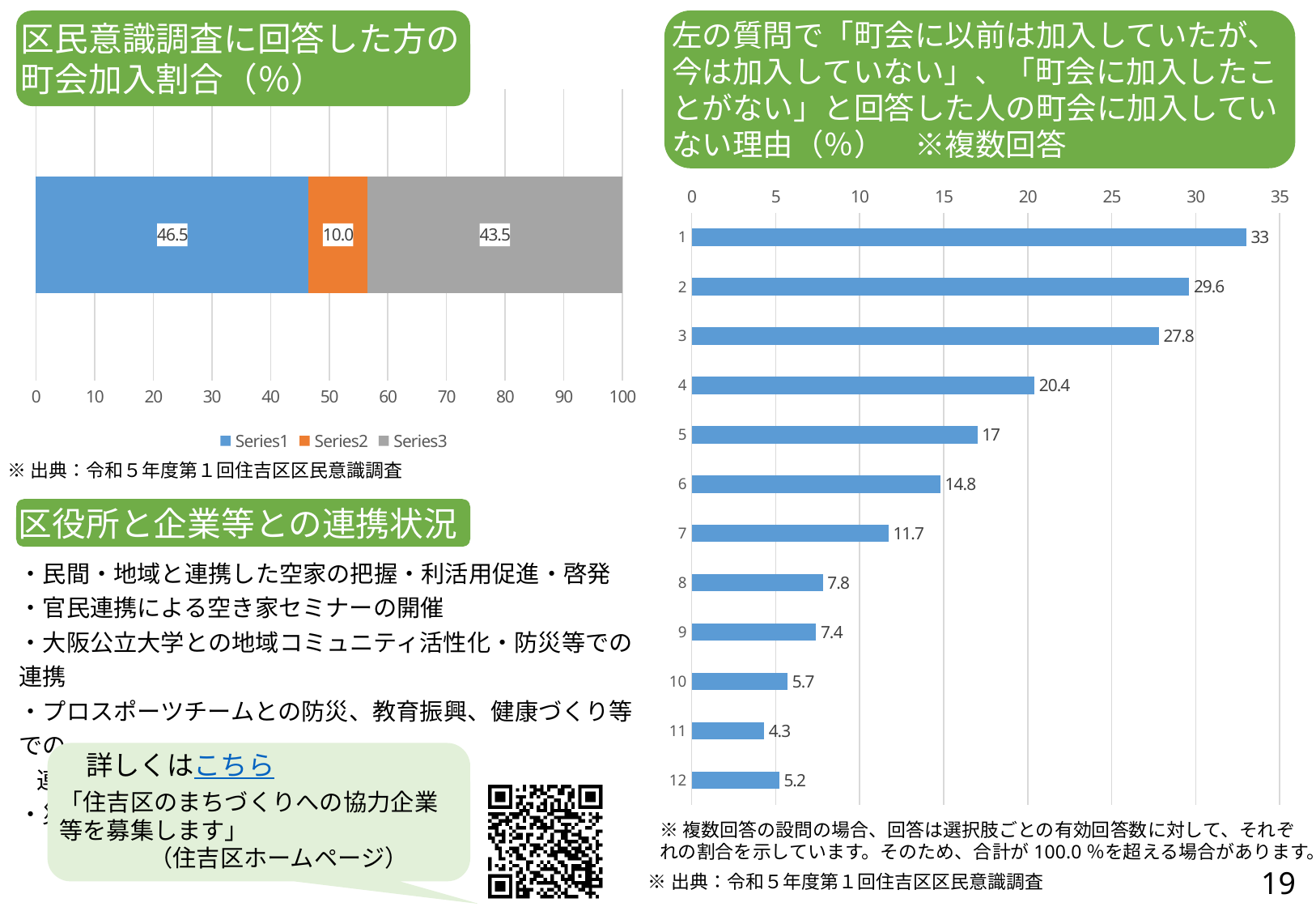
In the right chart (町会に加入していない理由), what is the value for category 1? 33 In the right chart (町会に加入していない理由), what is the value for category 7? 11.7 In the left chart (区民意識調査に回答した方の町会加入割合), which series has the smallest value? Series2 In the right chart (町会に加入していない理由), which category has the lowest value? 11 In the left chart (区民意識調査に回答した方の町会加入割合), what is the value for Series1? 46.5 In the left chart (区民意識調査に回答した方の町会加入割合), what is the value for Series2? 10.0 What kind of chart is the right chart (町会に加入していない理由)? bar chart In the right chart (町会に加入していない理由), which is larger, the value for category 11 or category 12? 12 In the left chart (区民意識調査に回答した方の町会加入割合), what is the total of the stacked bar? 100.0 In the right chart (町会に加入していない理由), what is the difference between the values for category 2 and category 3? 1.8 In the right chart (町会に加入していない理由), how many categories are plotted? 12 In the left chart (区民意識調査に回答した方の町会加入割合), how many series does the legend list? 3